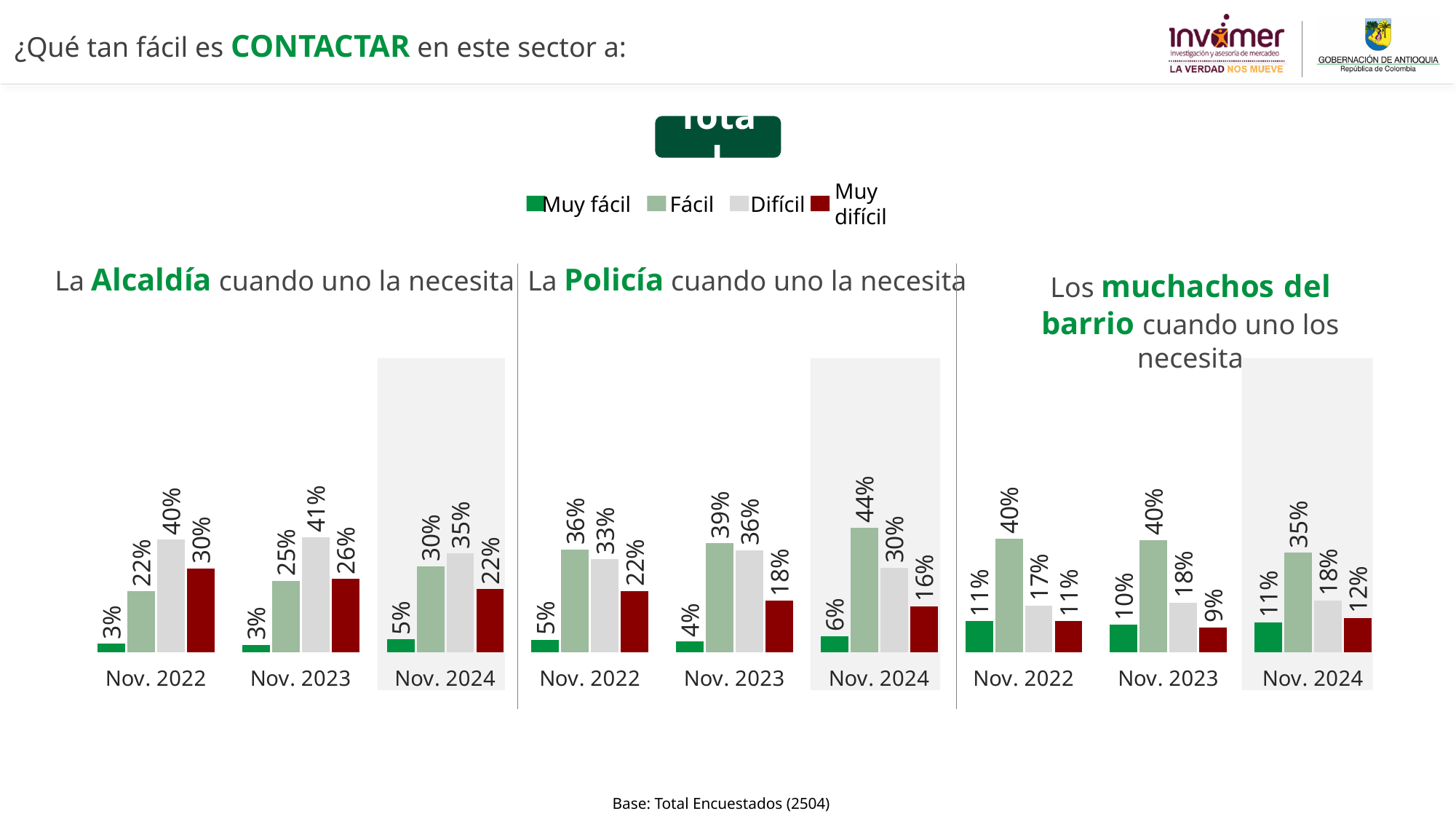
In the 'La Alcaldía cuando uno la necesita' chart, what is the difference between Muy difícil in Nov. 2022 and Muy difícil in Nov. 2024? 8% In the 'La Policía cuando uno la necesita' chart, does the Fácil value rise or fall from Nov. 2022 to Nov. 2024? rise What kind of chart is 'Los muchachos del barrio cuando uno los necesita'? bar chart How many time periods are shown on the x axis of the 'La Policía cuando uno la necesita' chart? 3 In the 'La Policía cuando uno la necesita' chart, which series has the lowest value in Nov. 2023? Muy fácil In the 'La Alcaldía cuando uno la necesita' chart, what is the value for Difícil in Nov. 2023? 41% In the 'La Alcaldía cuando uno la necesita' chart, which series has the highest value in Nov. 2022? Difícil In the 'La Alcaldía cuando uno la necesita' chart, does the Difícil value rise or fall from Nov. 2023 to Nov. 2024? fall In the 'La Policía cuando uno la necesita' chart, what is the value for Fácil in Nov. 2024? 44% In the 'Los muchachos del barrio cuando uno los necesita' chart, what is the value for Muy difícil in Nov. 2023? 9% How many series does the legend list? 4 In the 'Los muchachos del barrio cuando uno los necesita' chart, which is larger in Nov. 2024: Fácil or Difícil? Fácil